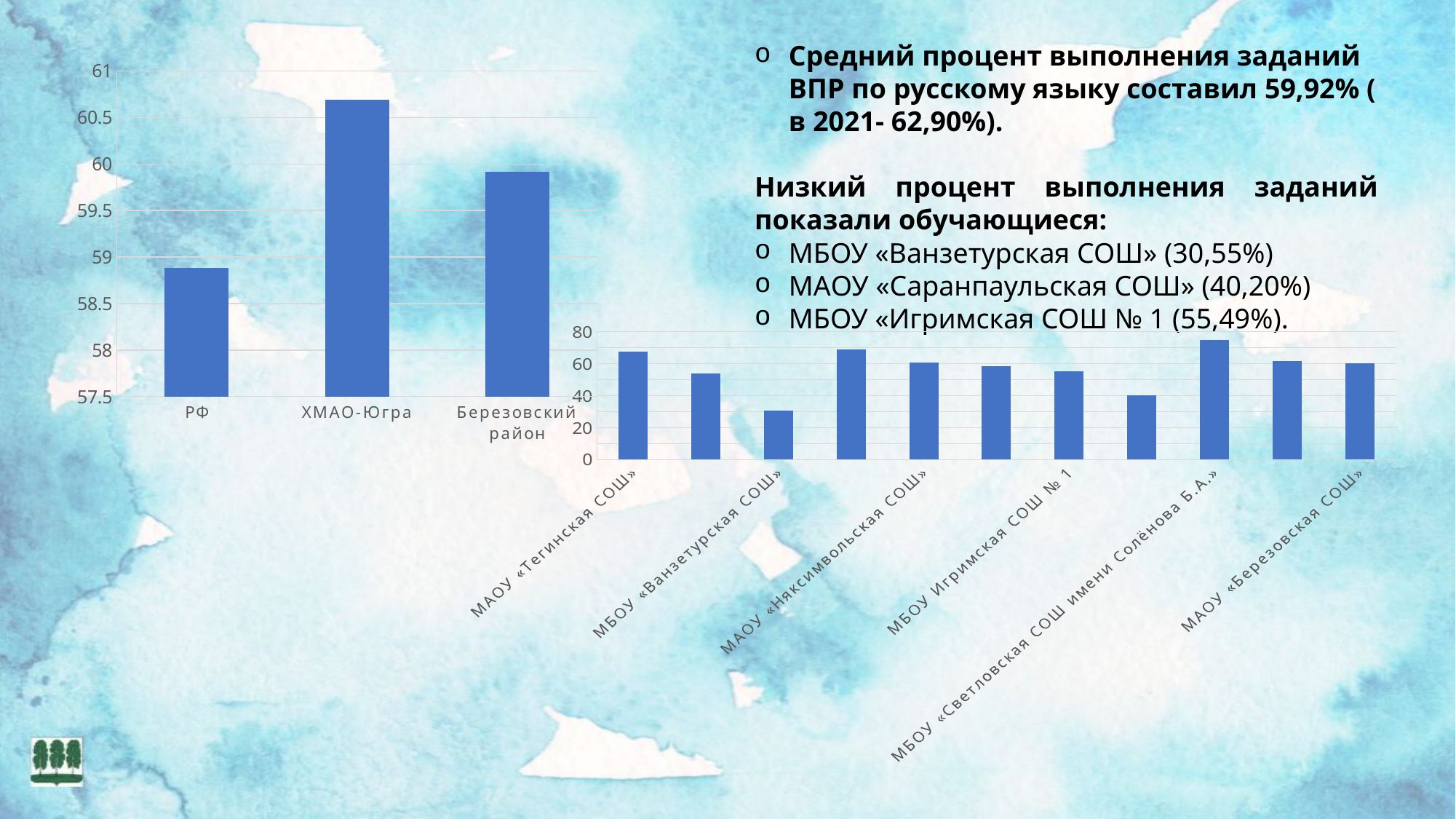
On the left chart, how many categories are plotted? 3 On the left chart, which category has the lowest value? РФ On the right chart, how many bars are plotted? 11 On the right chart, which is larger: the value for МАОУ «Тегинская СОШ» or МБОУ «Ванзетурская СОШ»? МАОУ «Тегинская СОШ» On the right chart, is the value for МАОУ «Тегинская СОШ» greater or less than 60? greater On the left chart, is the value for Березовский район greater or less than 60? less What type of chart is the left chart? bar chart On the left chart, is the value for РФ greater or less than 59? less On the left chart, which category has the highest value? ХМАО-Югра